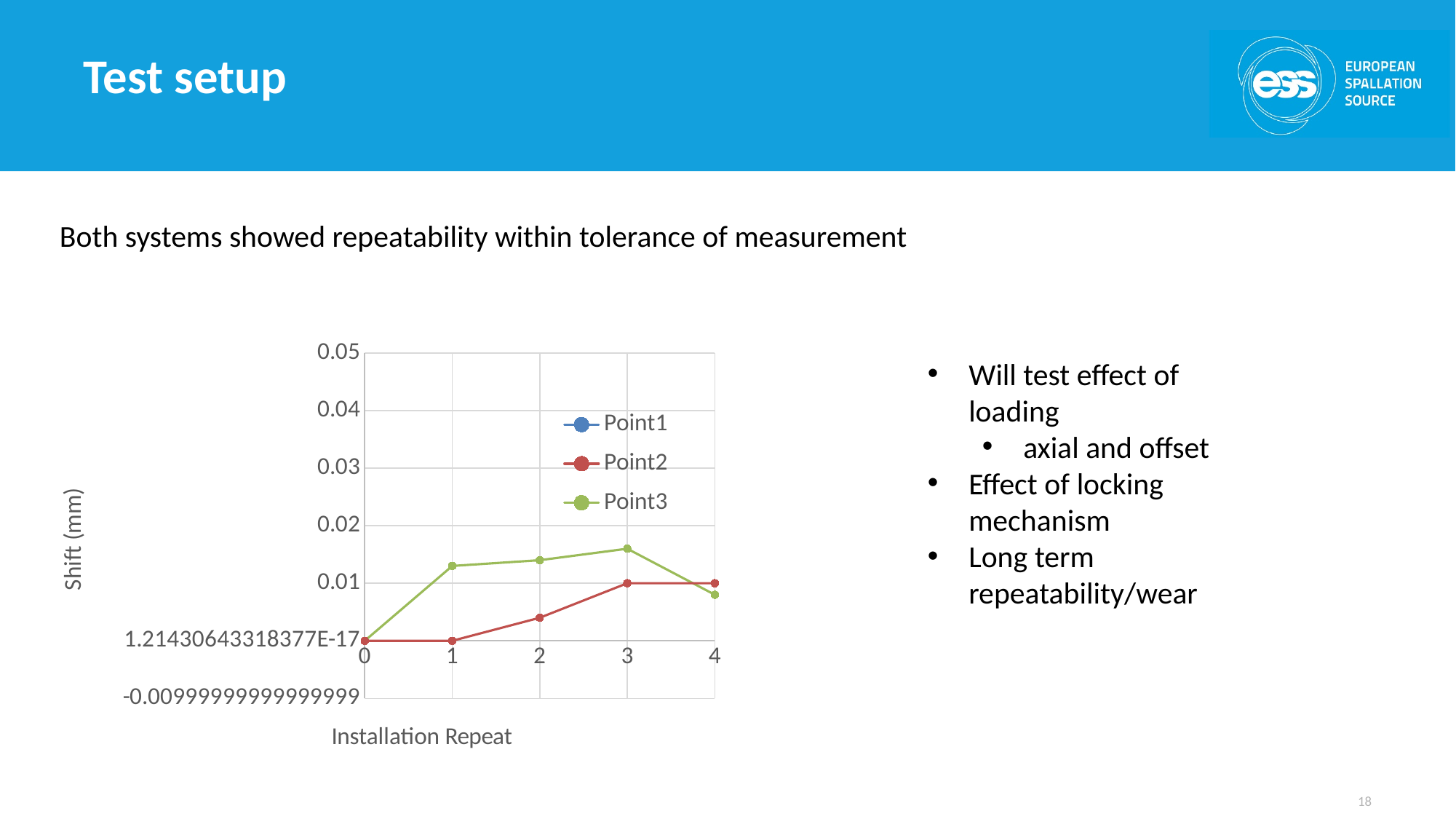
How many series does the chart legend list? 3 At which installation repeat does Point3 reach its highest value? 3 What is the value of Point2 at installation repeat 3? 0.01 Does the Point2 series rise or fall between installation repeat 1 and installation repeat 3? rise Is the value for Point3 at installation repeat 1 greater or less than 0.01? greater Is the value for Point3 at installation repeat 3 greater or less than 0.02? less What is the title of the y axis of the chart? Shift (mm) What is the title of the x axis of the chart? Installation Repeat How many installation repeats are shown along the x axis? 5 At installation repeat 2, which series has the larger value, Point2 or Point3? Point3 What is the value of Point2 at installation repeat 4? 0.01 What kind of chart is shown on the slide? line chart